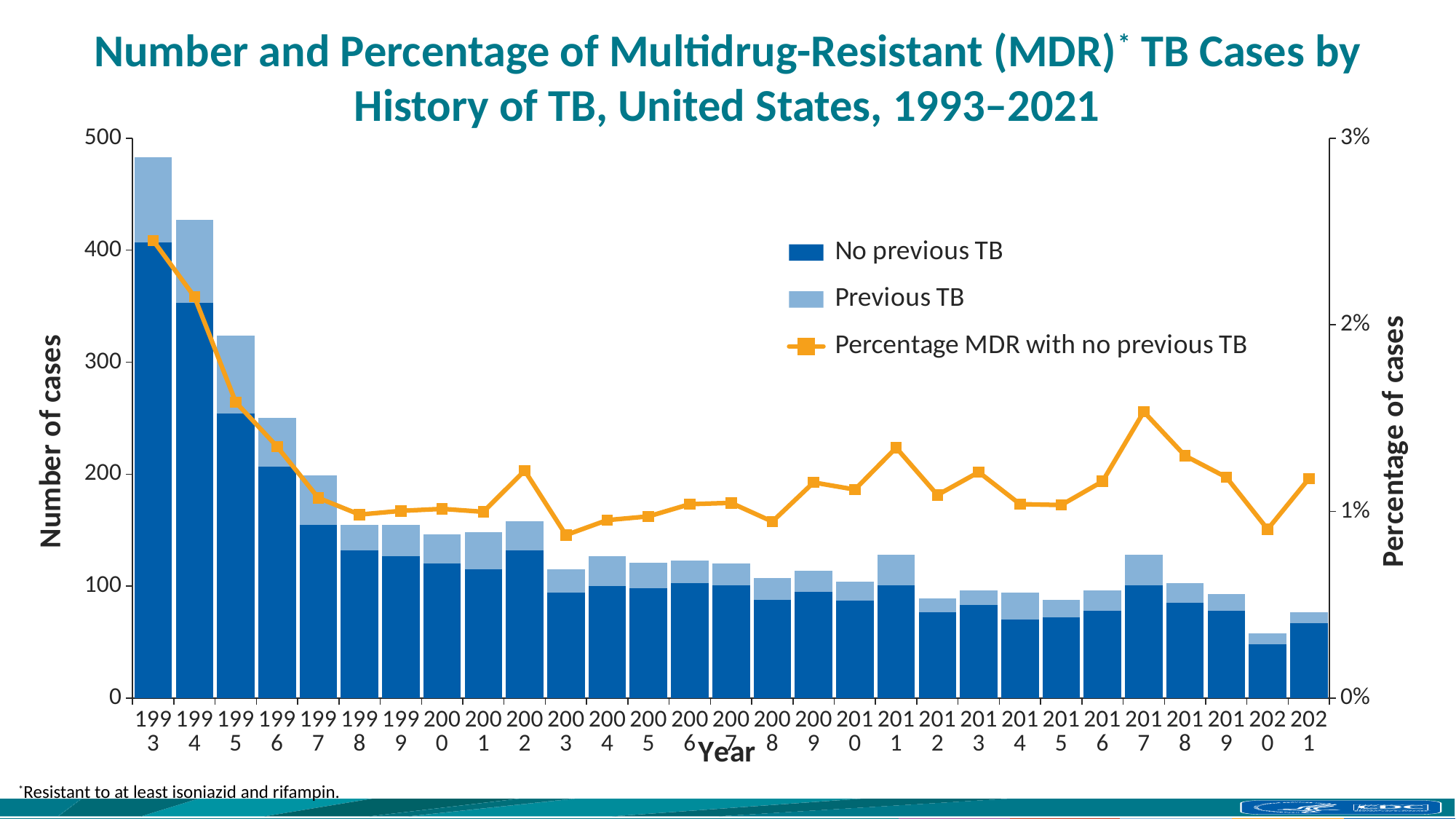
Which year has a higher percentage of MDR cases with no previous TB, 2017 or 2020? 2017 How many years are shown on the x axis? 29 How many series does the legend list? 3 Which year has more cases with no previous TB, 1994 or 1995? 1994 Is the number of cases with no previous TB in 2020 greater or less than 100? less In which year is the percentage of MDR cases with no previous TB highest? 1993 Is the percentage of MDR cases with no previous TB in 1993 greater or less than 2%? greater Is the number of cases with no previous TB in 1993 greater or less than 300? greater Does the number of cases with no previous TB rise or fall from 1993 to 1997? fall In which year is the number of MDR TB cases with no previous TB lowest? 2020 In which year is the number of MDR TB cases with no previous TB highest? 1993 What kind of chart is shown on the slide? Combined bar and line chart